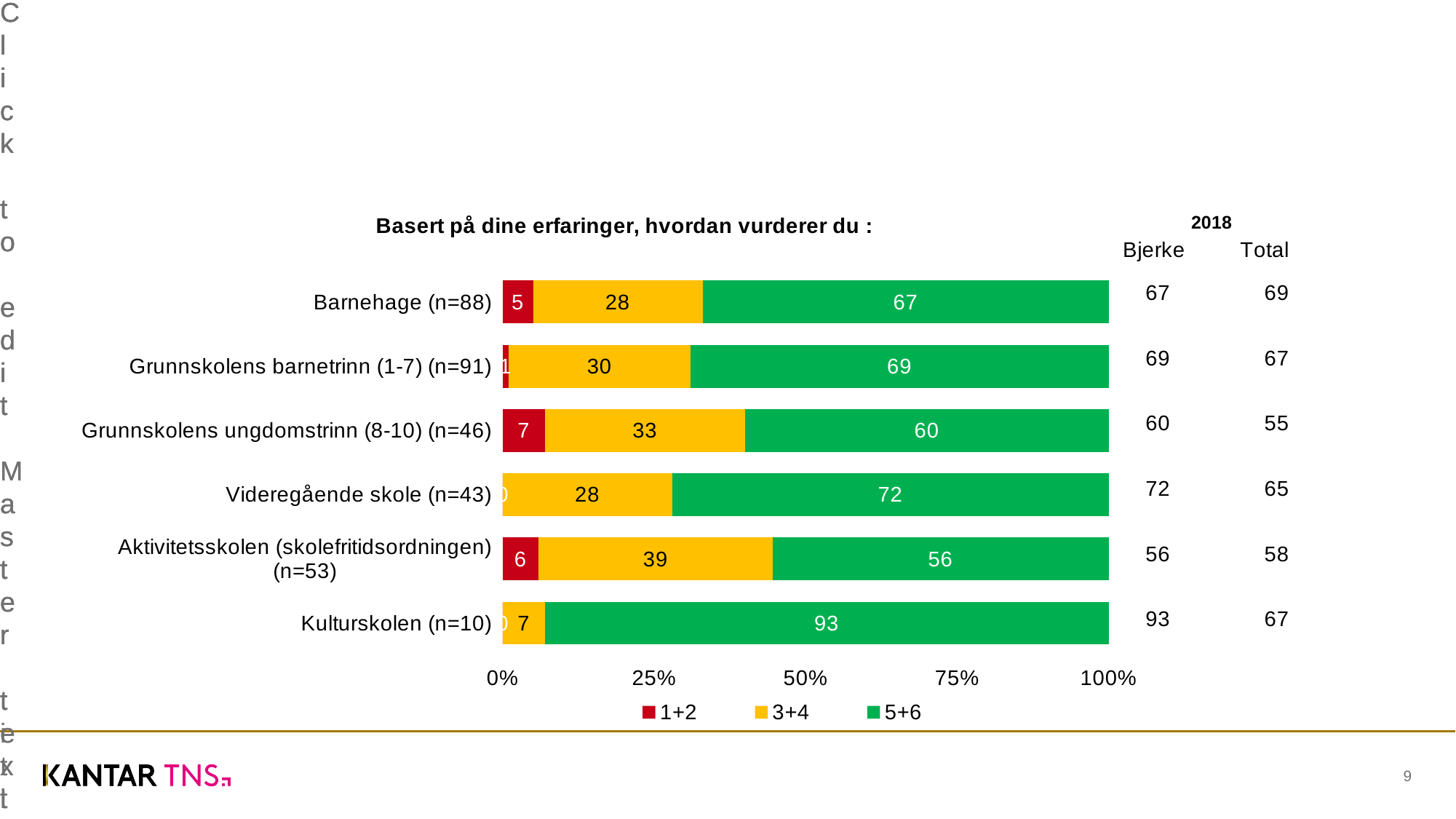
Which category has the lowest 5+6 value? Aktivitetsskolen (skolefritidsordningen) (n=53) What is the difference between the 5+6 value for Kulturskolen (n=10) and the 5+6 value for Barnehage (n=88)? 26 What is the value of the 5+6 segment for Barnehage (n=88)? 67 What kind of chart is shown on the slide? Stacked bar chart How many categories are shown in the chart? 6 What is the value of the 1+2 segment for Grunnskolens ungdomstrinn (8-10) (n=46)? 7 Which has the larger 3+4 value: Grunnskolens ungdomstrinn (8-10) (n=46) or Grunnskolens barnetrinn (1-7) (n=91)? Grunnskolens ungdomstrinn (8-10) (n=46) Which category has the highest 5+6 value? Kulturskolen (n=10) What is the value of the 3+4 segment for Aktivitetsskolen (skolefritidsordningen) (n=53)? 39 How many series does the legend list? 3 What is the title of the chart? Basert på dine erfaringer, hvordan vurderer du : Which category has the highest 3+4 value? Aktivitetsskolen (skolefritidsordningen) (n=53)